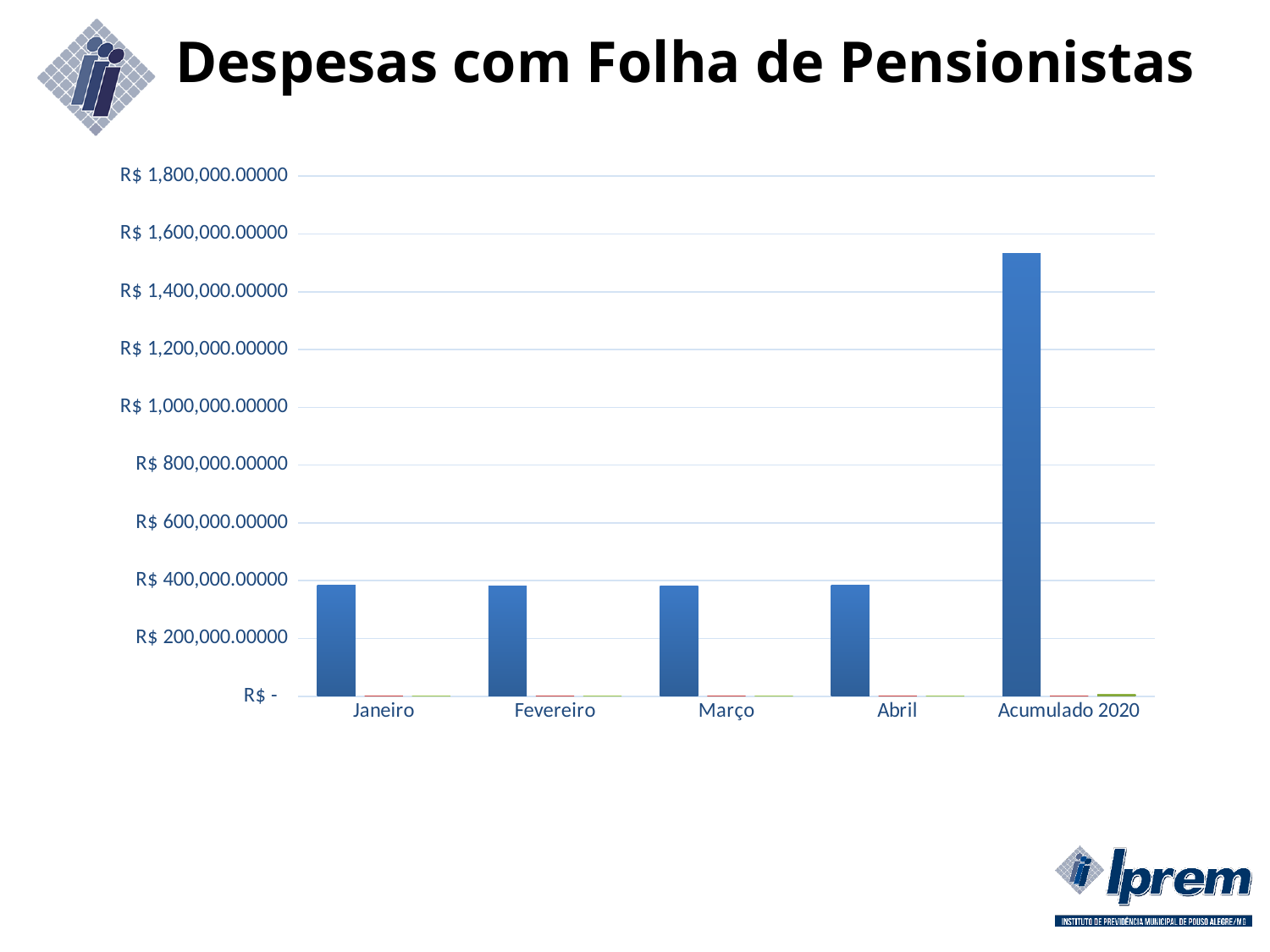
Is the blue bar for Março greater or less than R$ 600,000.00000? less What kind of chart is shown on the slide? bar chart How many categories are shown on the x axis of the chart? 5 What is the title of the chart? Despesas com Folha de Pensionistas Is the blue bar for Acumulado 2020 greater or less than R$ 1,600,000.00000? less Is the blue bar for Acumulado 2020 greater or less than R$ 1,400,000.00000? greater What is the label of the last category on the x axis? Acumulado 2020 Which has a larger blue bar, Abril or Acumulado 2020? Acumulado 2020 Which category has the highest blue bar in the chart? Acumulado 2020